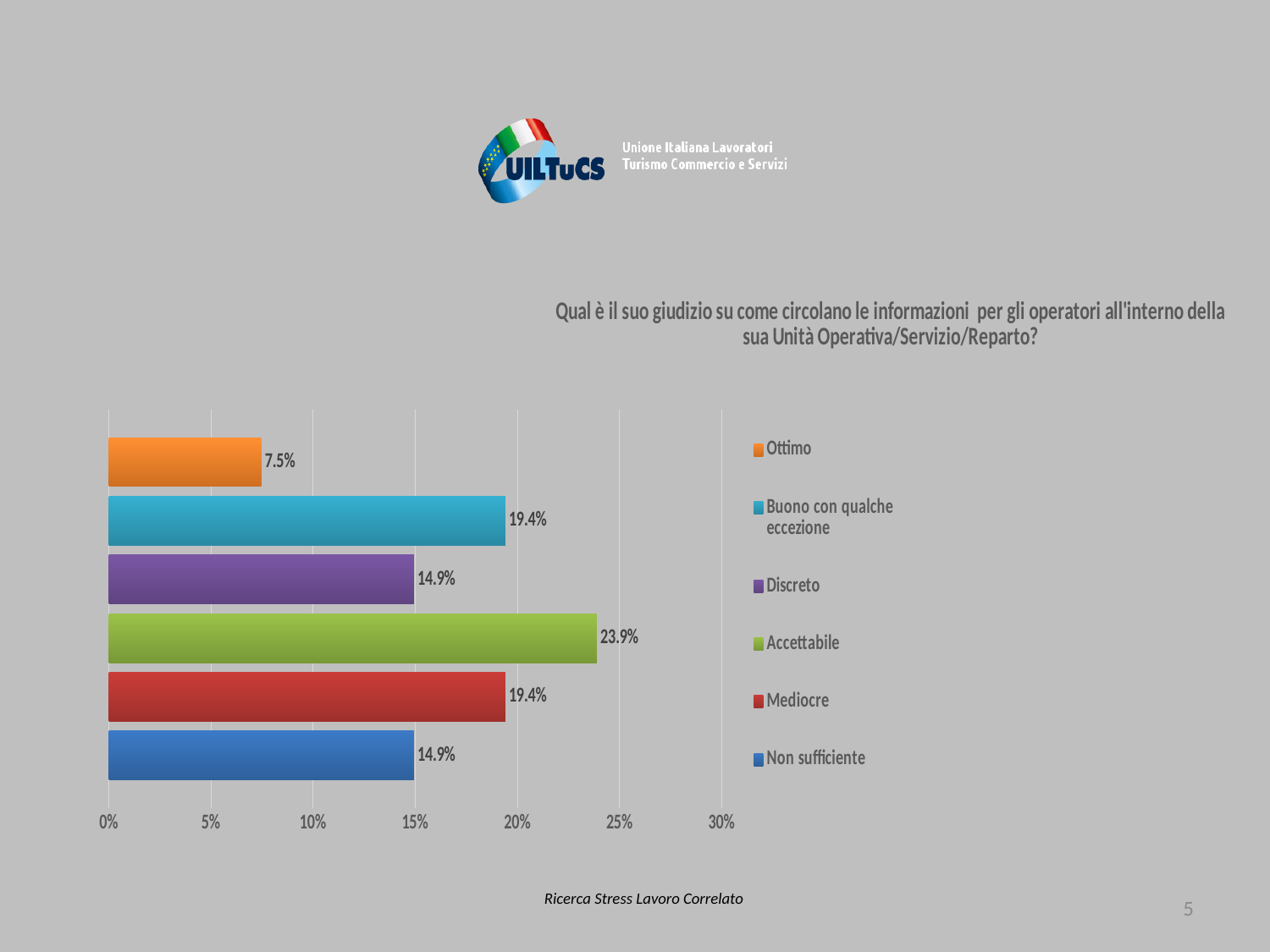
What is the value for Discreto? 14.9% What is the value for Mediocre? 19.4% What kind of chart is shown on the slide? Bar chart Which category has the lowest value? Ottimo How many entries does the legend list? 6 How many bars are plotted in the chart? 6 What is the value for Ottimo? 7.5% What is the value for Accettabile? 23.9% Which category has the highest value? Accettabile Is the value for Accettabile greater or less than 20%? greater What is the difference between the values for Accettabile and Ottimo? 16.4% Which is larger, the value for Buono con qualche eccezione or the value for Non sufficiente? Buono con qualche eccezione